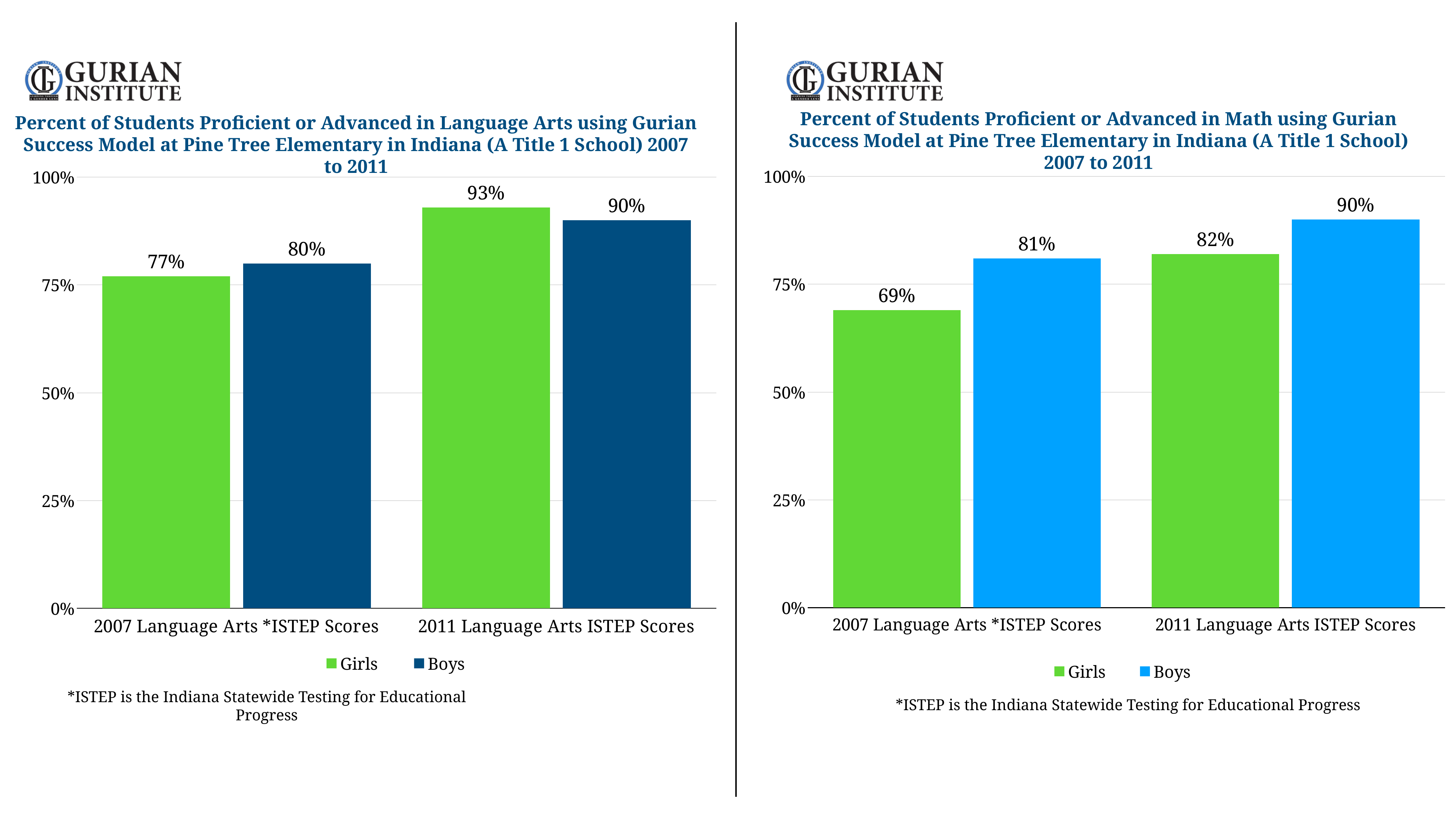
In the left chart (Language Arts), which bar has the highest value? Girls, 2011 Language Arts ISTEP Scores In the left chart (Language Arts), do the Boys values rise or fall from 2007 to 2011? Rise In the right chart (Math), what is the value for Girls in 2007 Language Arts *ISTEP Scores? 69% In the right chart (Math), which bar has the lowest value? Girls, 2007 Language Arts *ISTEP Scores In the left chart (Language Arts), what is the difference between the Girls values for 2011 and 2007? 16% In the right chart (Math), what is the difference between the Boys values for 2011 and 2007? 9% In the right chart (Math), which is larger in 2007: Girls or Boys? Boys In the right chart (Math), what is the value for Boys in 2011 Language Arts ISTEP Scores? 90% In the left chart (Language Arts), what is the value for Girls in 2007 Language Arts *ISTEP Scores? 77% In the left chart (Language Arts), how many series does the legend list? 2 What kind of chart is the right chart (Math)? Bar chart In the left chart (Language Arts), what is the value for Boys in 2011 Language Arts ISTEP Scores? 90%